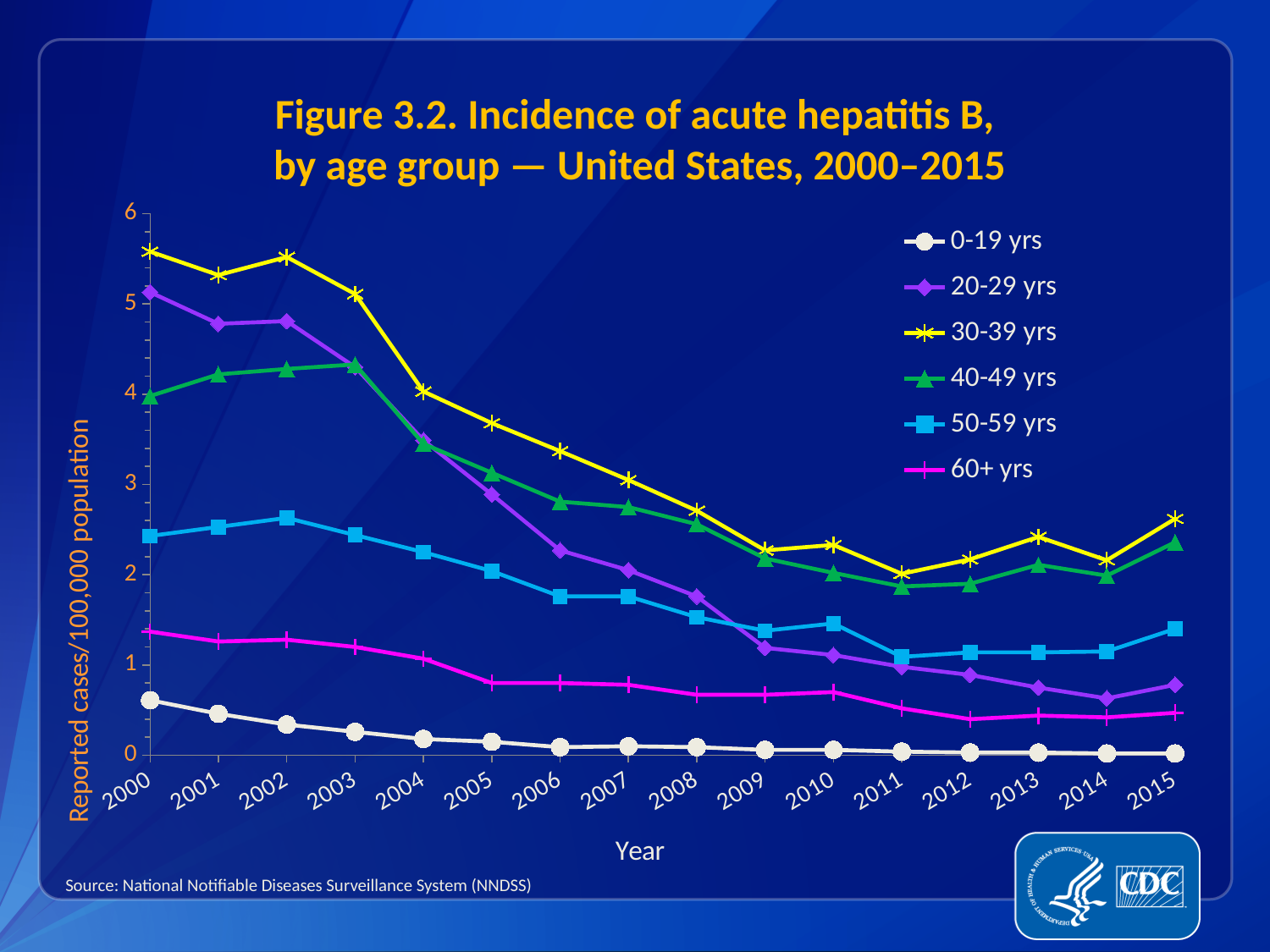
Does the incidence for the 0-19 yrs group rise or fall from 2000 to 2015? fall Which age group had the lowest incidence of acute hepatitis B in 2015? 0-19 yrs Which age group had the highest incidence of acute hepatitis B in 2015? 30-39 yrs What type of chart is shown on the slide? line chart Is the value for the 20-29 yrs group in 2015 greater or less than 1? less What is the label on the y axis? Reported cases/100,000 population In 2008, which had the higher incidence: the 30-39 yrs group or the 50-59 yrs group? 30-39 yrs Which age group had the highest incidence of acute hepatitis B in 2000? 30-39 yrs Is the value for the 60+ yrs group in 2000 greater or less than 1? greater How many years are plotted along the x axis? 16 Is the value for the 30-39 yrs group in 2000 greater or less than 5? greater How many age-group series does the legend list? 6